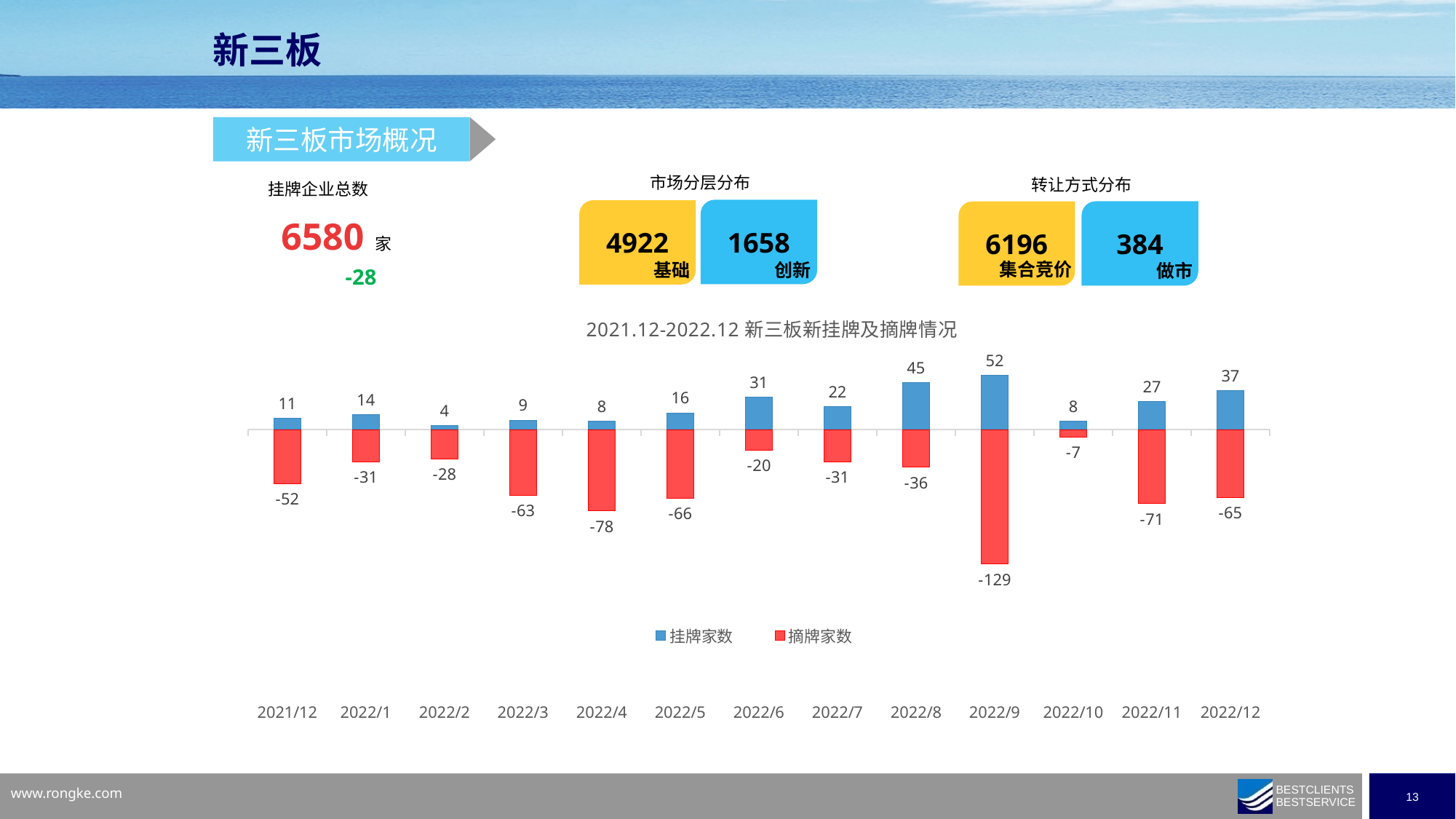
Which month has the lowest 挂牌家数? 2022/2 Which month has the highest 挂牌家数? 2022/9 What is the value of 挂牌家数 for 2022/2? 4 What is the difference between 挂牌家数 for 2022/12 and 2022/11? 10 What is the title of the chart? 2021.12-2022.12 新三板新挂牌及摘牌情况 Which is larger, 挂牌家数 for 2022/6 or 2022/7? 2022/6 What is the value of 挂牌家数 for 2022/9? 52 What type of chart is shown? Bar chart How many series does the legend list? 2 Which month has the largest 摘牌家数 (most negative value)? 2022/9 How many months are shown on the x axis? 13 What is the value of 摘牌家数 for 2022/4? -78